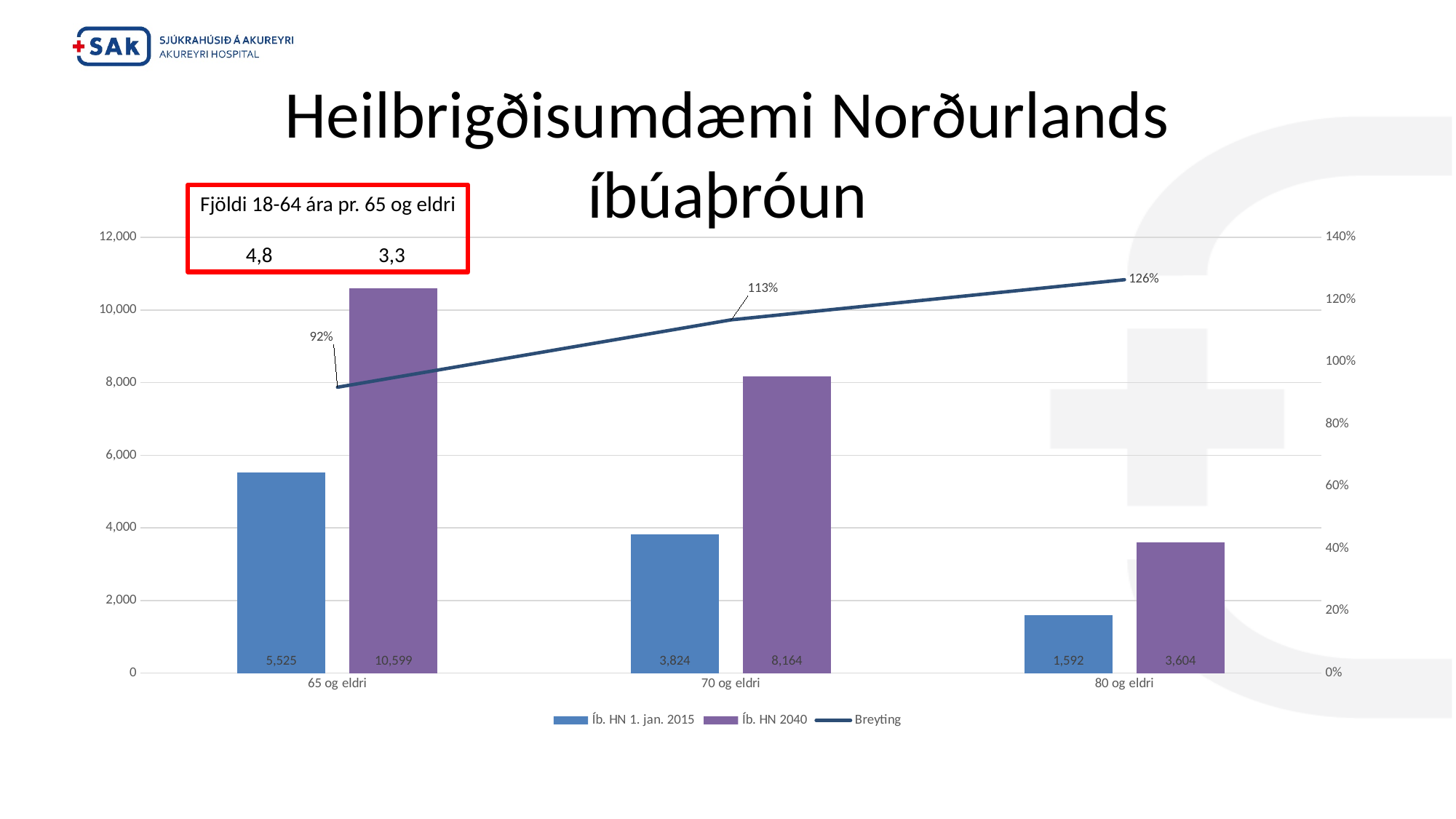
Does the Breyting line rise or fall from 65 og eldri to 80 og eldri? rises What is the Breyting value for the 80 og eldri category? 126% Which is larger for the 70 og eldri category: Íb. HN 1. jan. 2015 or Íb. HN 2040? Íb. HN 2040 What is the value for Íb. HN 1. jan. 2015 in the 65 og eldri category? 5,525 Which category has the highest value for Íb. HN 2040? 65 og eldri What is the title of the chart? Heilbrigðisumdæmi Norðurlands íbúaþróun Which category has the lowest value for Íb. HN 1. jan. 2015? 80 og eldri What is the value for Íb. HN 2040 in the 80 og eldri category? 3,604 What is the difference between Íb. HN 2040 and Íb. HN 1. jan. 2015 for the 65 og eldri category? 5,074 How many categories are shown on the x axis? 3 How many series does the legend list? 3 What is the value for Íb. HN 2040 in the 70 og eldri category? 8,164